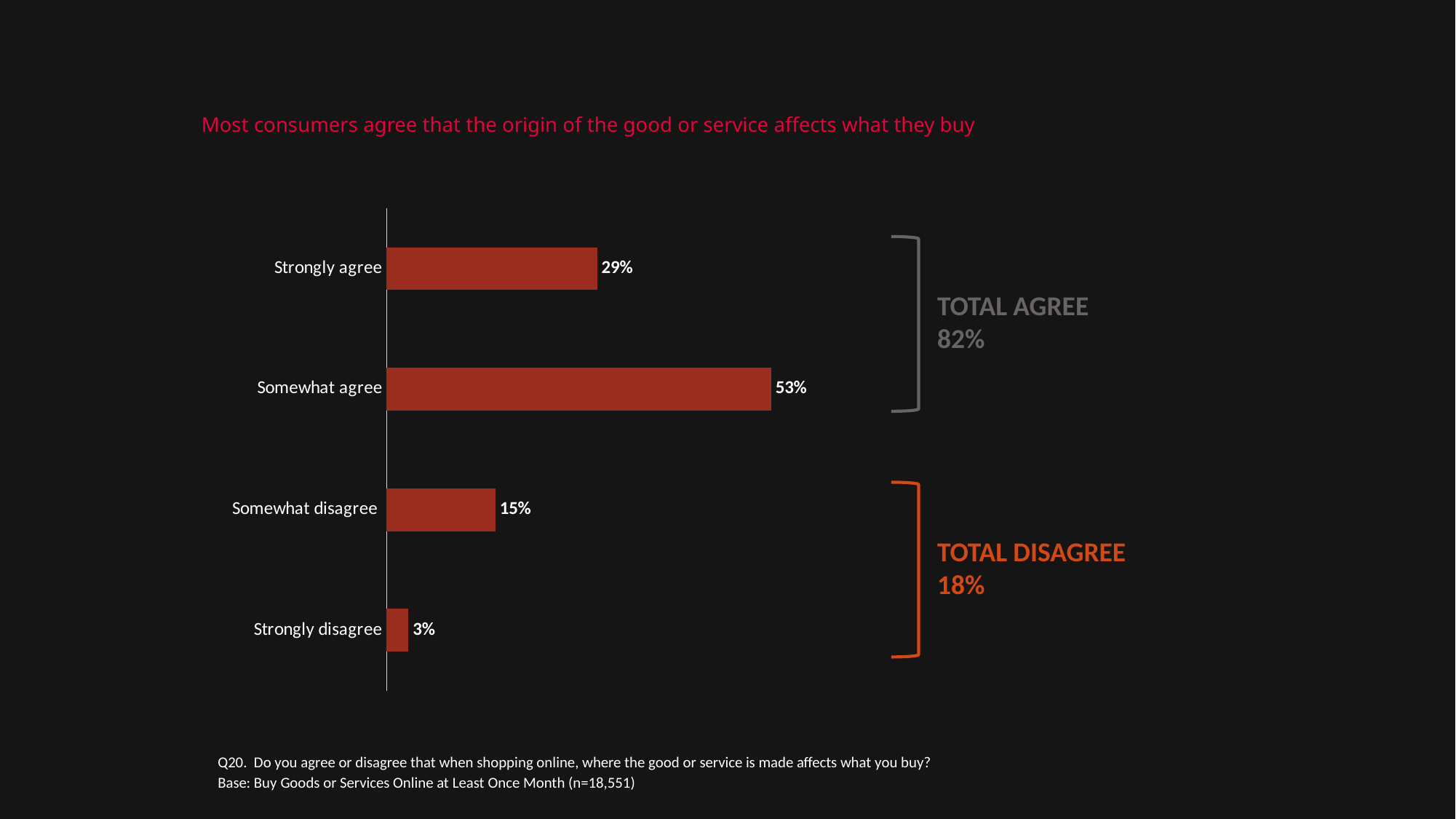
Which response category has the lowest percentage? Strongly disagree What type of chart is shown on the slide? Bar chart What is the Total Disagree percentage shown on the slide? 18% How many response categories are shown in the chart? 4 What percentage of respondents somewhat agree? 53% What is the Total Agree percentage shown on the slide? 82% Which is larger, the Somewhat disagree or the Strongly agree percentage? Strongly agree What percentage of respondents strongly disagree? 3% What percentage of respondents somewhat disagree? 15% What is the difference between the Somewhat agree and Strongly agree percentages? 24% Which response category has the highest percentage? Somewhat agree What percentage of respondents strongly agree? 29%